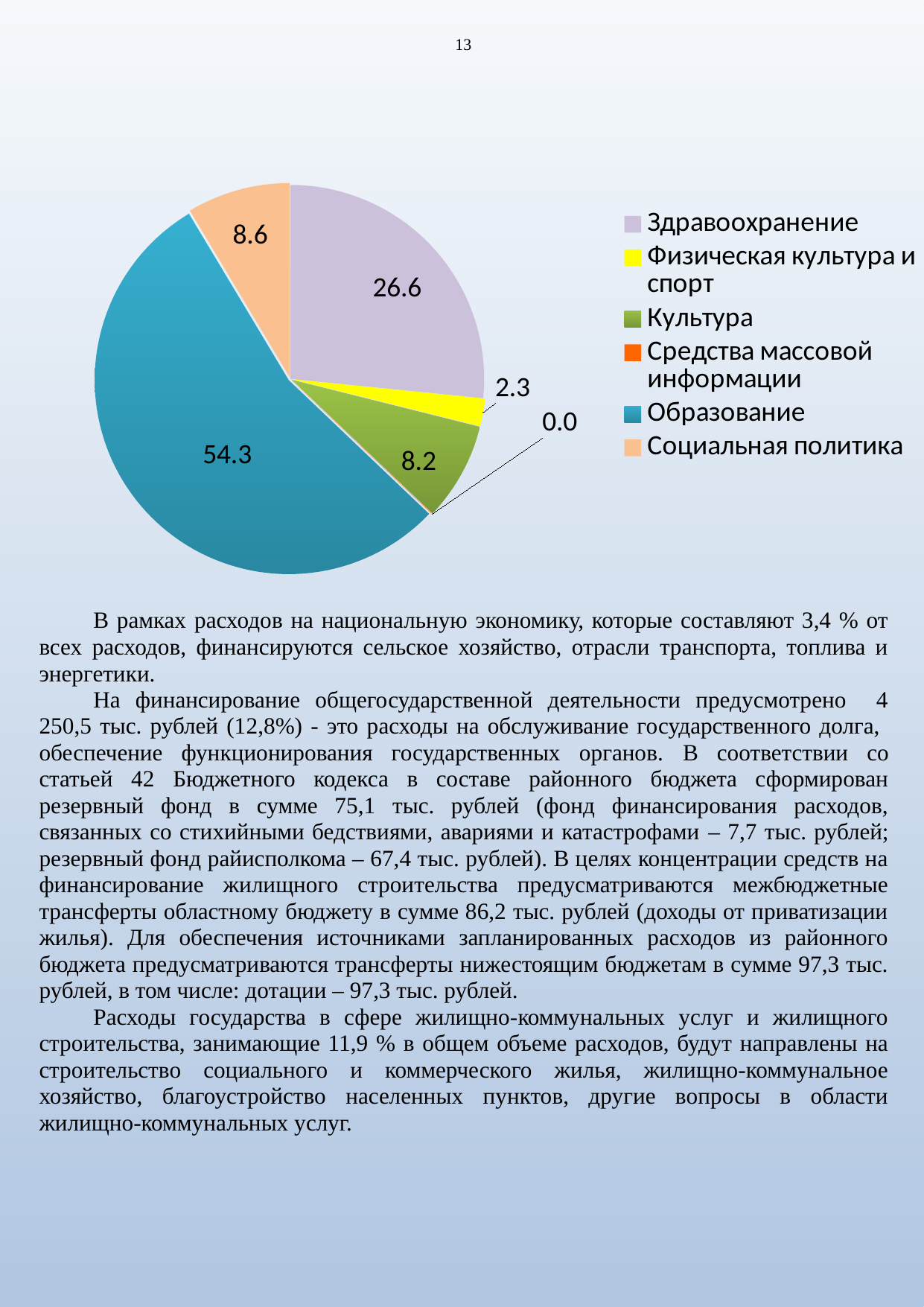
Which category has the smallest slice of the pie chart? Средства массовой информации What type of chart is shown on the slide? Pie chart Which colour represents Образование in the legend? Blue (teal) What value is shown for the Культура slice? 8.2 What value is shown for the Здравоохранение slice? 26.6 What value is shown for the Социальная политика slice? 8.6 What value is shown for the Образование slice of the pie chart? 54.3 Which is larger, the value for Социальная политика or the value for Культура? Социальная политика What value is shown for the Физическая культура и спорт slice? 2.3 Which category has the largest slice of the pie chart? Образование What is the difference between the values for Образование and Здравоохранение? 27.7 How many categories does the pie chart show? 6